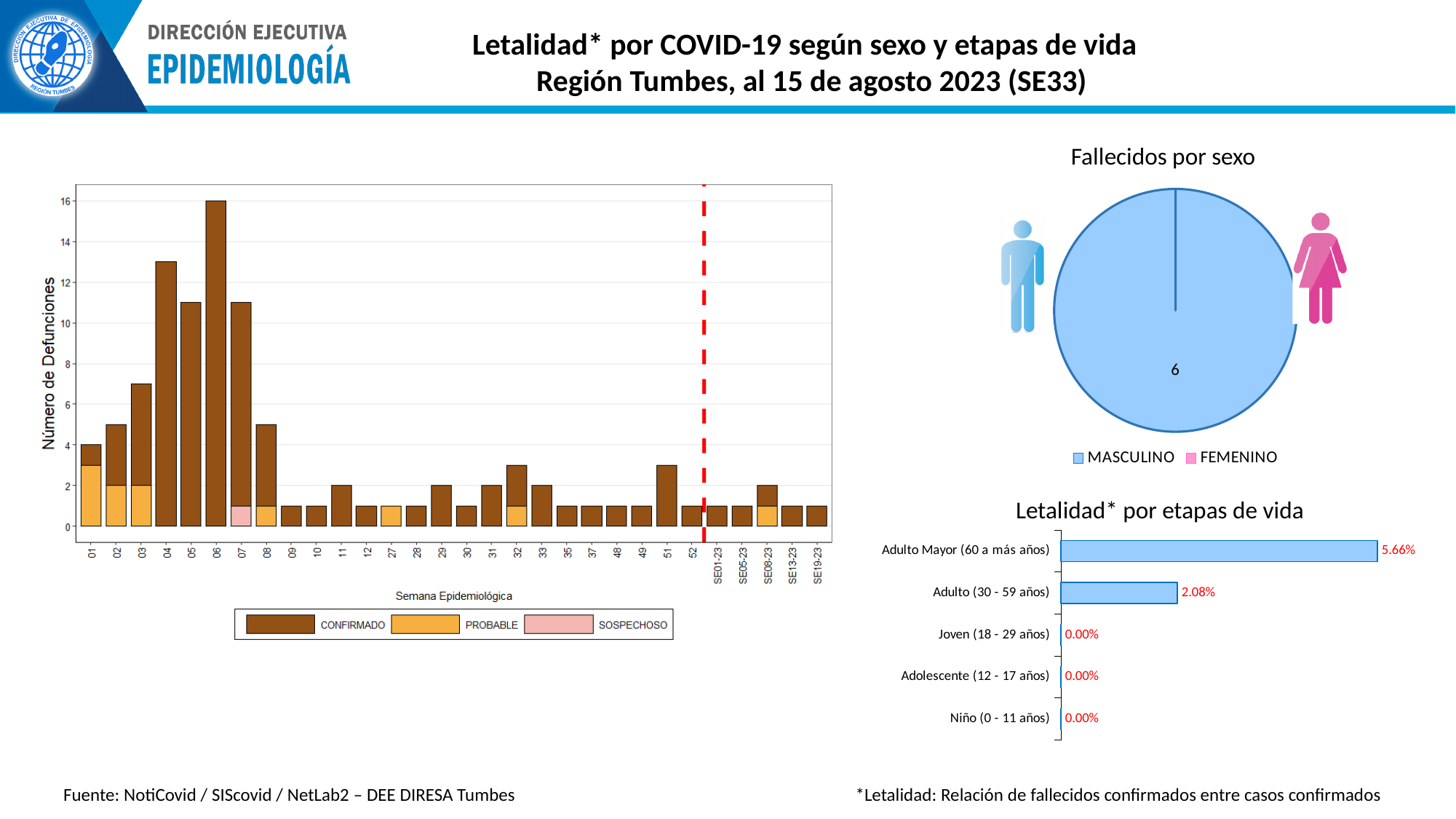
How many age groups are shown in the 'Letalidad* por etapas de vida' chart? 5 In the 'Número de Defunciones' bar chart on the left, which epidemiological week has the highest total number of deaths? 06 In the 'Número de Defunciones' bar chart on the left, what is the total number of deaths in week 06? 16 In the 'Fallecidos por sexo' pie chart, what value is shown for MASCULINO? 6 In the 'Número de Defunciones' bar chart on the left, is the total for week 04 greater or less than 12? greater In the 'Letalidad* por etapas de vida' chart, what is the value for Adulto Mayor (60 a más años)? 5.66% In the 'Letalidad* por etapas de vida' chart, what is the value for Adulto (30 - 59 años)? 2.08% How many categories does the legend of the 'Fallecidos por sexo' pie chart list? 2 How many series does the legend of the 'Número de Defunciones' bar chart on the left list? 3 In the 'Letalidad* por etapas de vida' chart, what is the difference between the values for Adulto Mayor (60 a más años) and Adulto (30 - 59 años)? 3.58% What kind of chart is 'Letalidad* por etapas de vida'? Bar chart In the 'Letalidad* por etapas de vida' chart, which age group has the highest value? Adulto Mayor (60 a más años)